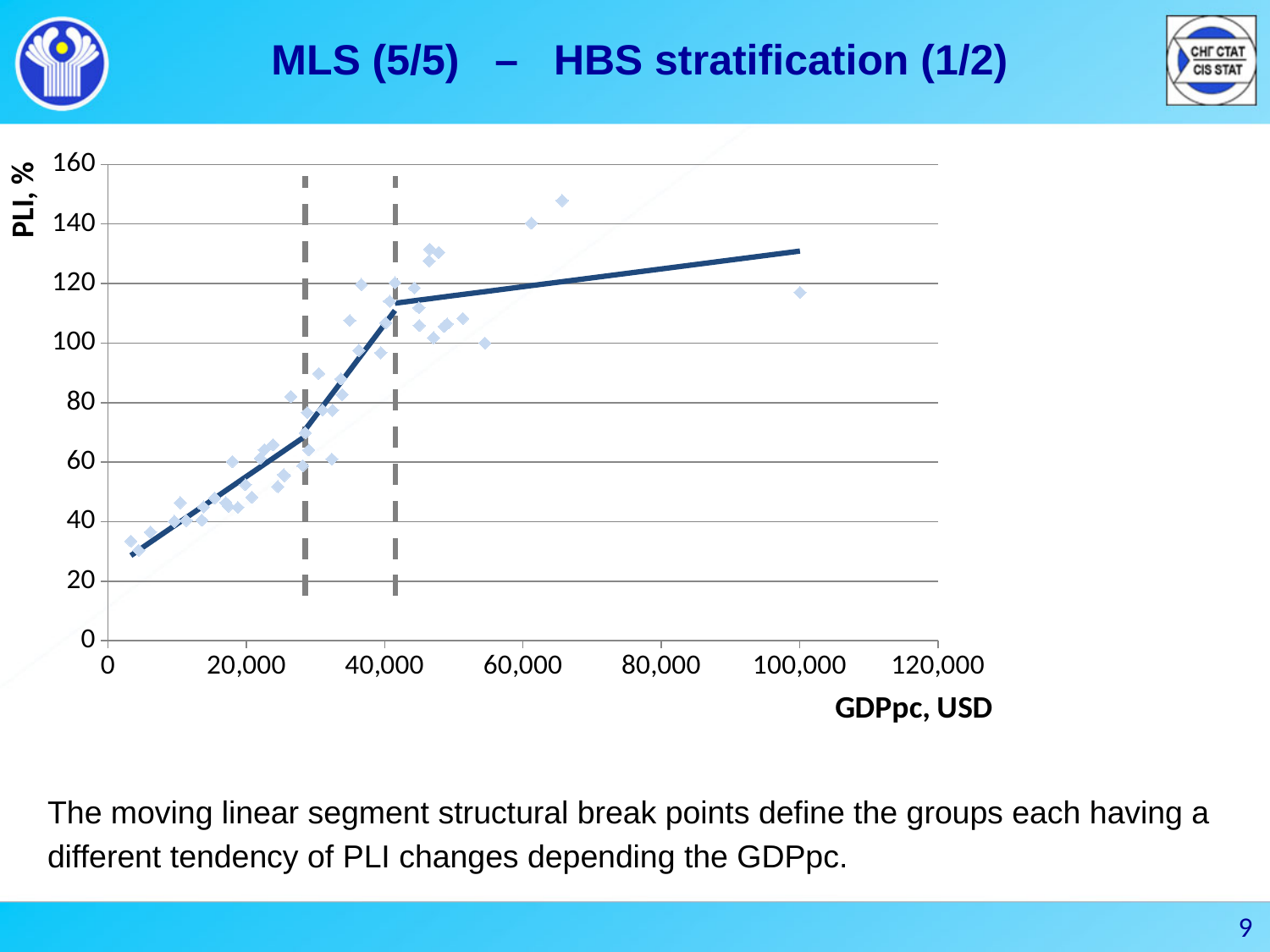
Is the PLI value of the point at about 100,000 USD GDPpc greater or less than 140? less Is the PLI value of the lowest point on the chart greater or less than 40? less What is the label of the y axis? PLI, % How many vertical dashed lines are drawn on the chart? 2 What is the highest tick value shown on the x axis? 120,000 Is the PLI value of the point at about 100,000 USD GDPpc greater or less than 100? greater What is the highest tick value shown on the y axis? 160 What kind of chart is shown on the slide? scatter chart Does PLI generally rise or fall as GDPpc increases along the x axis? rise